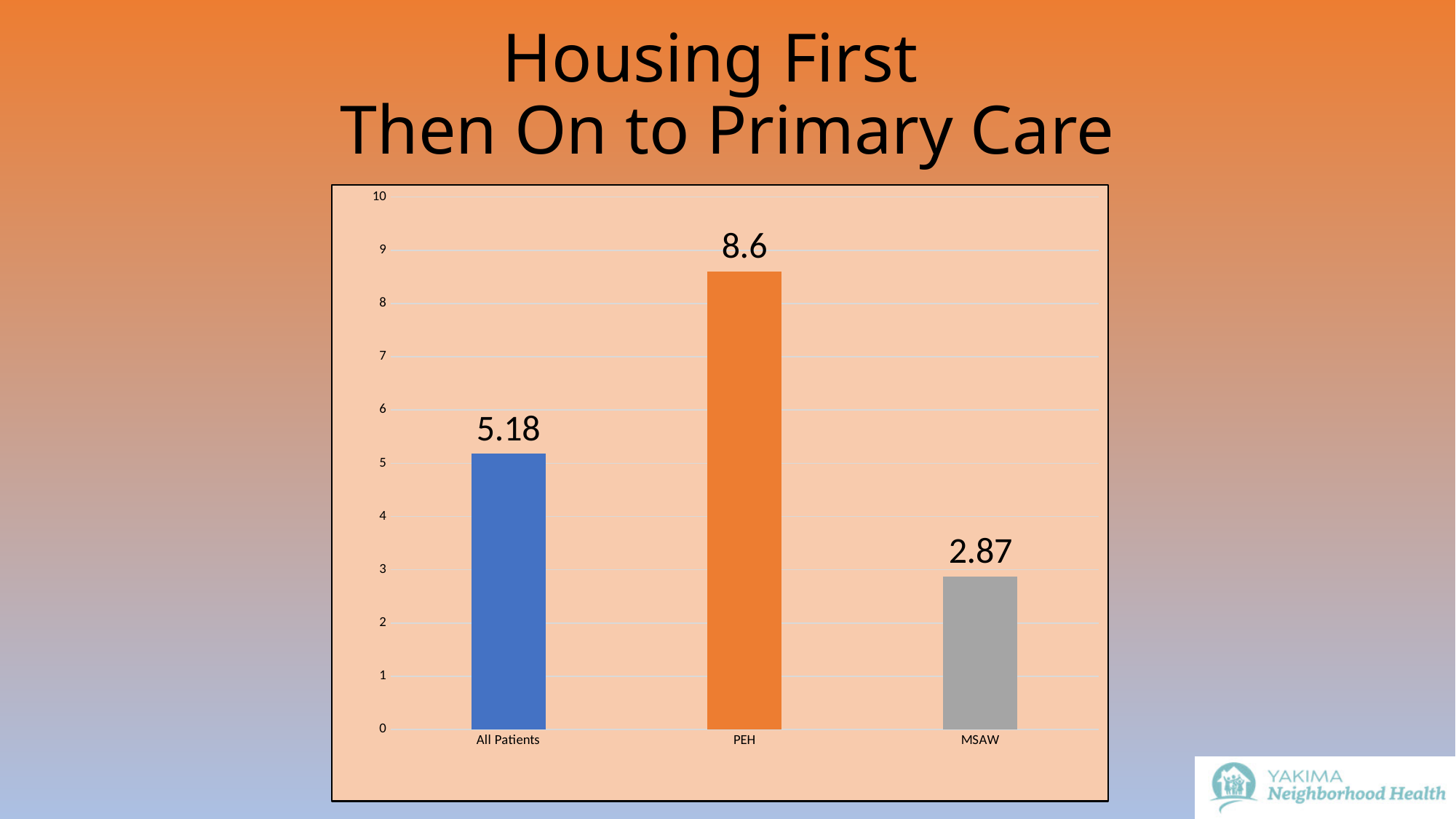
What is the difference between the values for All Patients and MSAW? 2.31 What kind of chart is shown on the slide? bar chart What colour is the bar for PEH? orange What is the difference between the values for PEH and All Patients? 3.42 Is the value for PEH greater or less than 8? greater Which category has the highest value? PEH What is the value for MSAW? 2.87 What is the value for All Patients? 5.18 What is the value for PEH? 8.6 Which is larger, the value for All Patients or the value for MSAW? All Patients Which category has the lowest value? MSAW How many categories are shown on the chart? 3